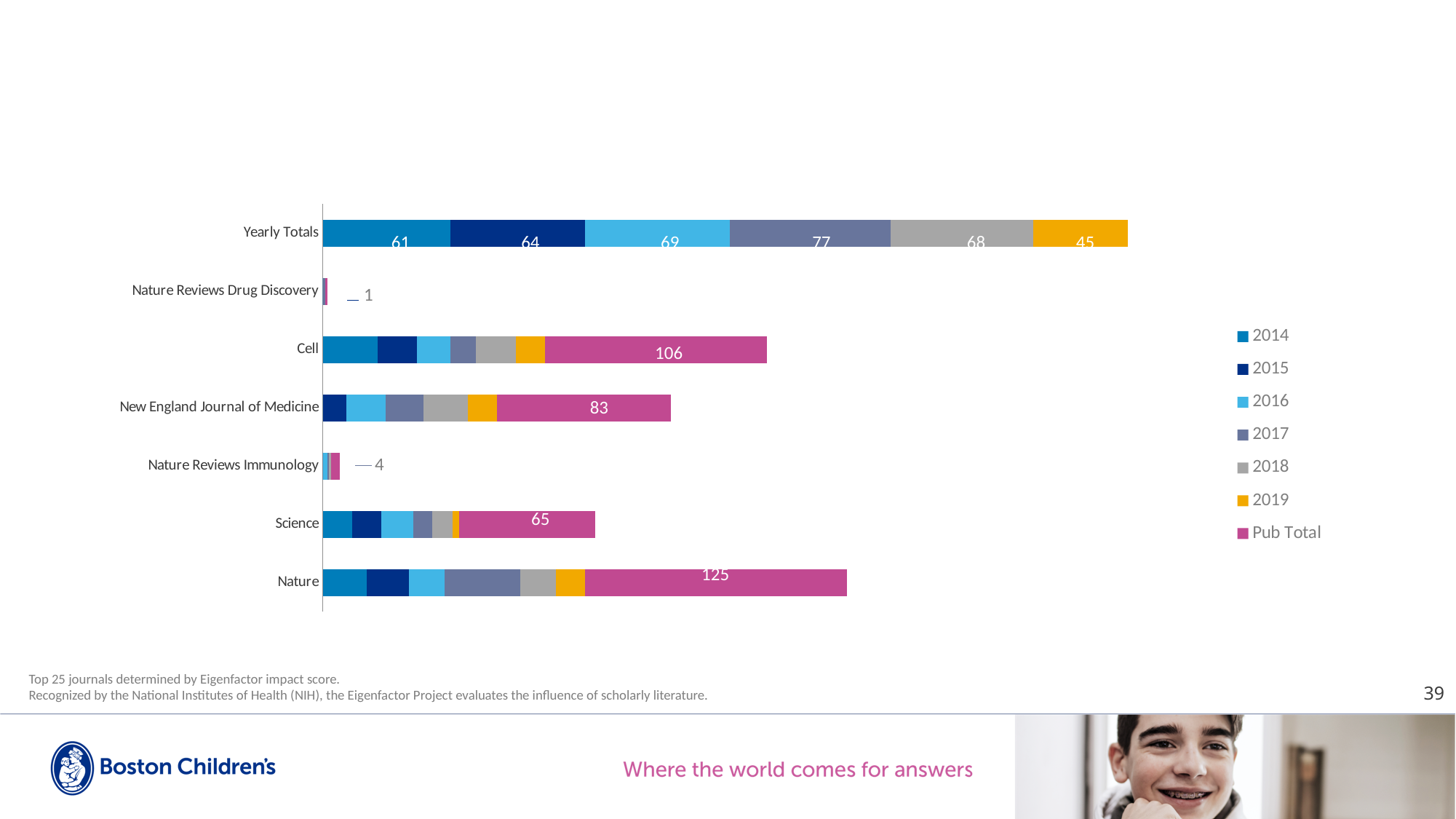
What is the Pub Total value for Nature? 125 What is the Pub Total value for Cell? 106 Which year has the highest value in the Yearly Totals bar? 2017 In the Yearly Totals bar, what is the value for 2017? 77 What is the total of the Yearly Totals stacked bar (sum of the 2014 to 2019 values)? 384 Which has the larger Pub Total, Science or New England Journal of Medicine? New England Journal of Medicine How many categories are shown on the vertical axis of the chart? 7 In the Yearly Totals bar, what is the value for 2019? 45 What is the difference between the Pub Total for Nature and the Pub Total for Cell? 19 What kind of chart is shown on the slide? Stacked bar chart Which journal has the lowest Pub Total? Nature Reviews Drug Discovery How many series does the legend list? 7